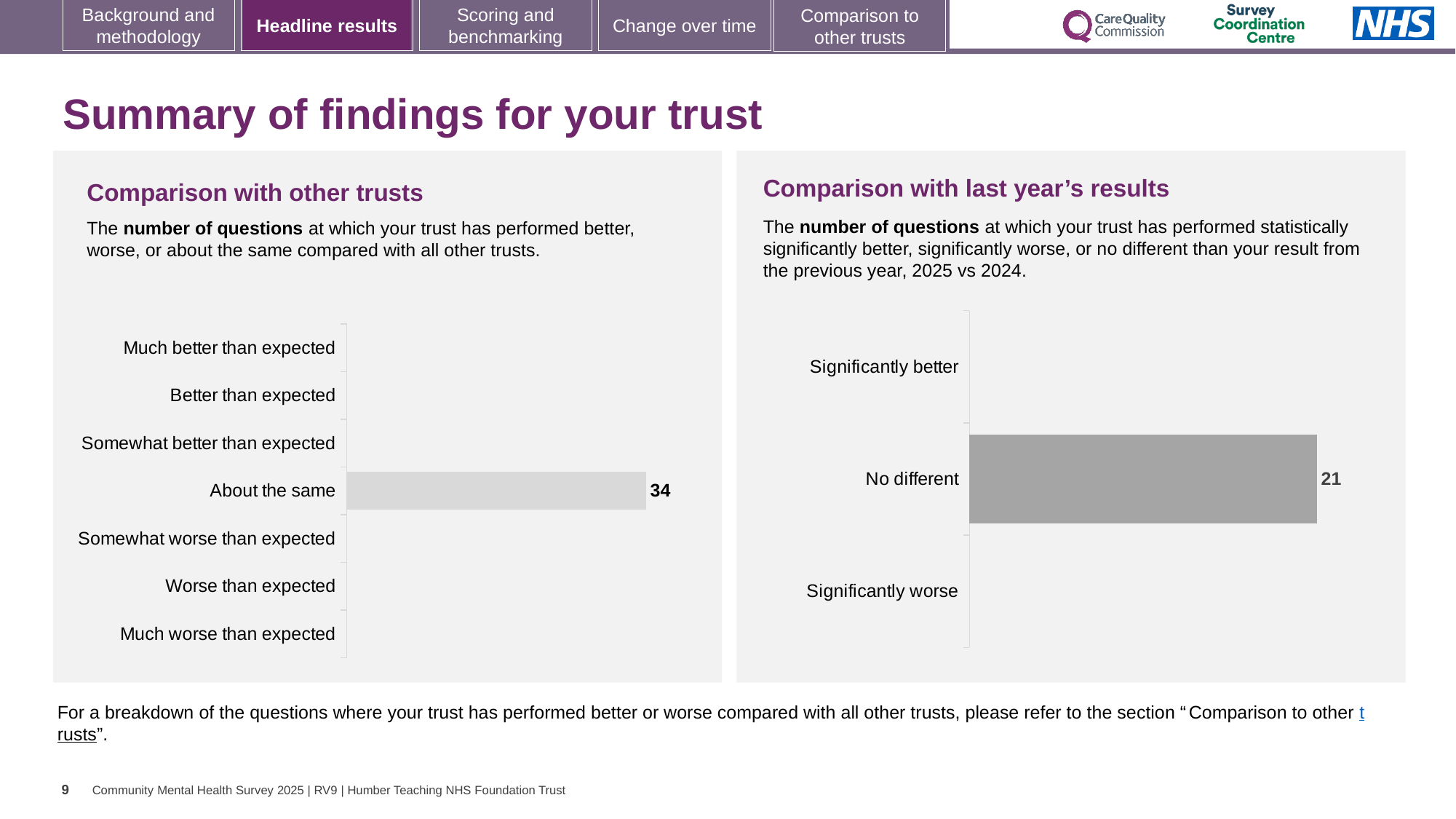
In the 'Comparison with other trusts' chart, what is the value for 'About the same'? 34 How many categories are listed on the axis of the 'Comparison with other trusts' chart? 7 What kind of chart is the 'Comparison with last year's results' chart? Bar chart In the 'Comparison with last year's results' chart, which category has the highest value? No different In the 'Comparison with last year's results' chart, what is the value for 'No different'? 21 What is the title of the chart on the right side of the slide? Comparison with last year's results What is the difference between the 'About the same' value in the left chart and the 'No different' value in the right chart? 13 Which is larger: the 'About the same' value in the 'Comparison with other trusts' chart or the 'No different' value in the 'Comparison with last year's results' chart? About the same In the 'Comparison with other trusts' chart, which category has the highest value? About the same How many categories are listed on the axis of the 'Comparison with last year's results' chart? 3 What kind of chart is the 'Comparison with other trusts' chart? Bar chart In the 'Comparison with other trusts' chart, how many categories have a visible bar? 1